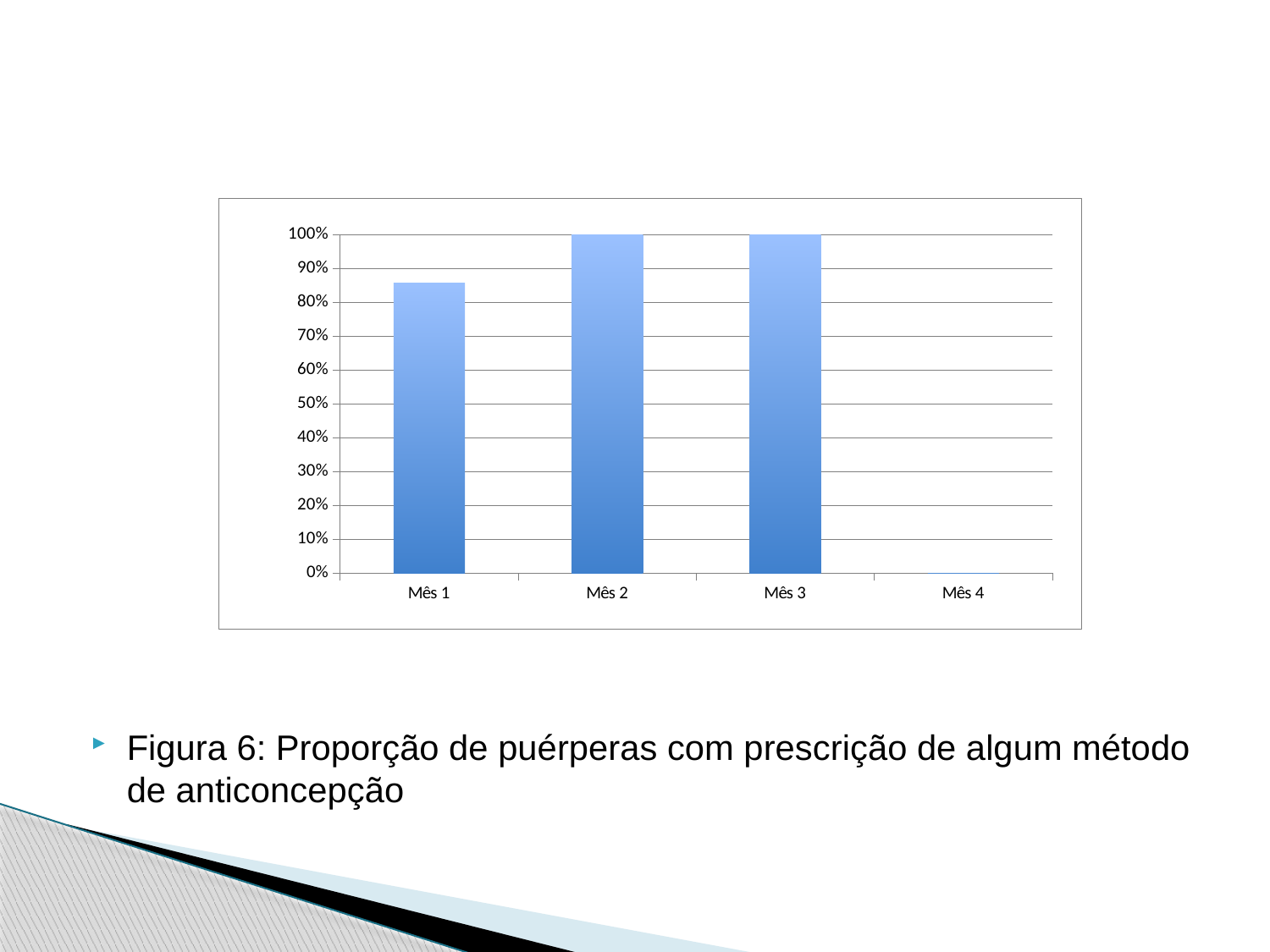
Does the value rise or fall from Mês 1 to Mês 2? Rise What is the figure caption shown below the chart? Figura 6: Proporção de puérperas com prescrição de algum método de anticoncepção Which is larger, the value for Mês 1 or the value for Mês 2? Mês 2 Among Mês 1, Mês 2 and Mês 3, which has the lowest value? Mês 1 What is the value for Mês 3? 100% Which categories reach 100%? Mês 2 and Mês 3 Is the value for Mês 1 greater or less than 90%? less What is the value for Mês 2? 100% Is the value for Mês 1 greater or less than 80%? greater How many categories are shown on the x axis of the chart? 4 What kind of chart is shown on the slide? Bar chart Is there a visible bar for Mês 4? No